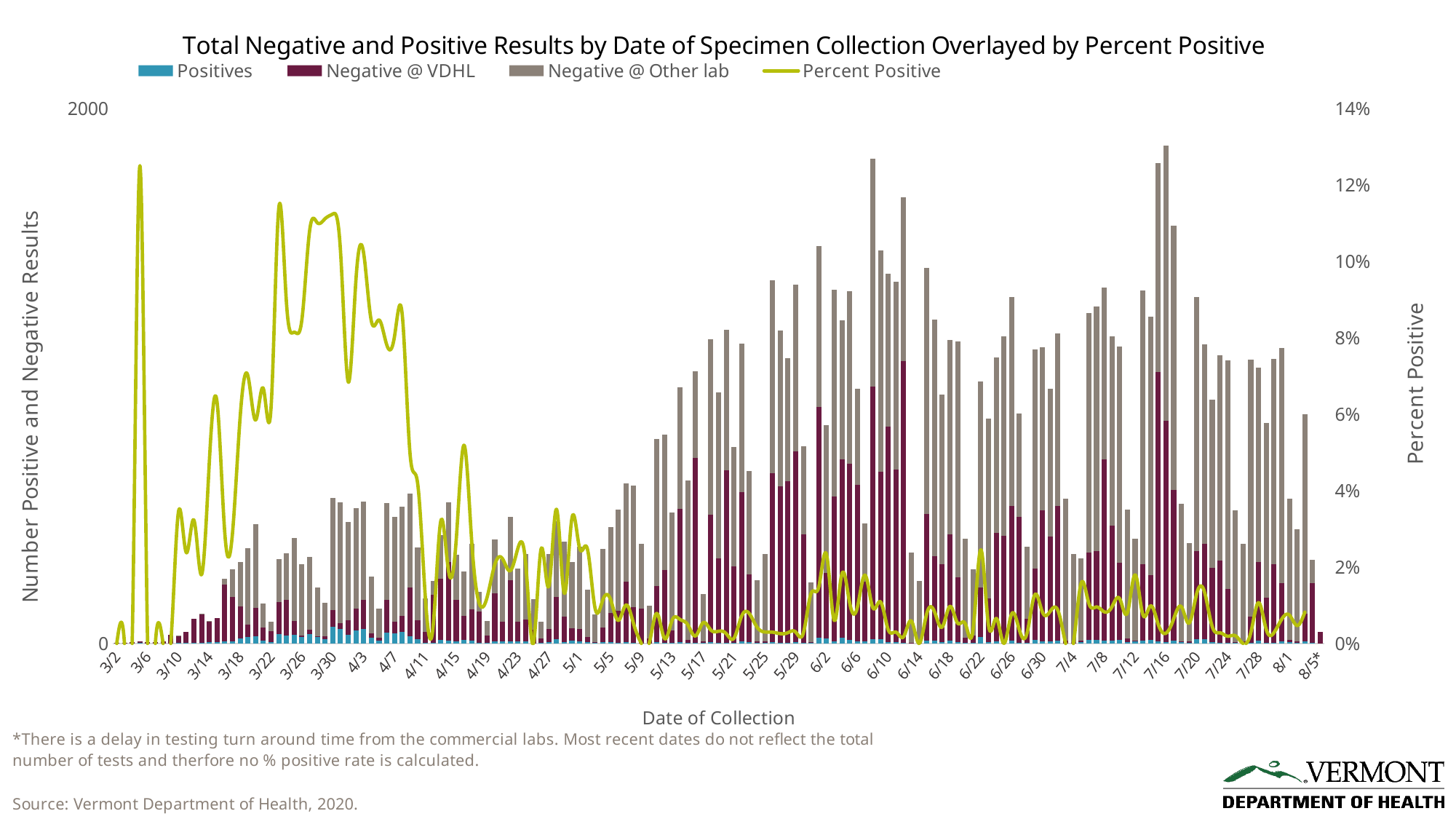
Does the Percent Positive line rise or fall between 4/7 and 4/11? fall What is the highest value shown on the right-hand Percent Positive axis? 14% Which is larger, the Percent Positive value on 3/30 or on 6/30? 3/30 What kind of chart is shown on the slide? A stacked bar chart with a line overlay Which series is plotted as a line rather than bars? Percent Positive How many series does the legend list? 4 What is the title of the chart? Total Negative and Positive Results by Date of Specimen Collection Overlayed by Percent Positive Is the total number of results on 7/16 greater or less than 2000? less Is the Percent Positive value on 3/22 greater or less than 10%? less Is the Percent Positive value on 7/16 greater or less than 4%? less